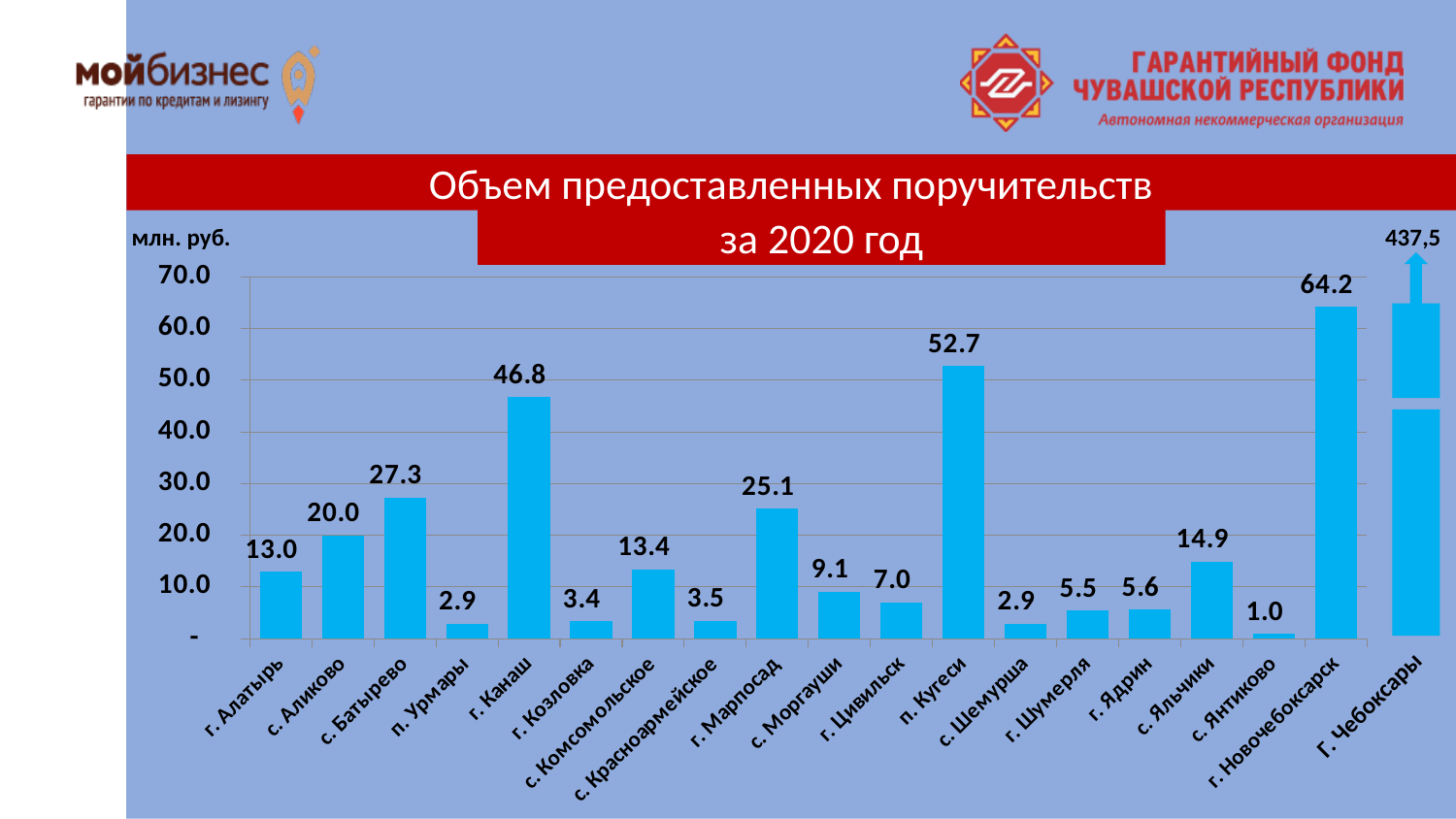
Which is larger, the value for г. Марпосад or the value for с. Аликово? г. Марпосад What is the difference between the values for г. Канаш and с. Батырево? 19.5 What is the difference between the values for г. Новочебоксарск and п. Кугеси? 11.5 What is the value for с. Батырево? 27.3 Which category has the lowest value? с. Янтиково Which category has the highest value? Г. Чебоксары What is the value for Г. Чебоксары? 437,5 What unit is shown above the vertical axis? млн. руб. How many categories are shown on the x axis? 19 What is the value for п. Кугеси? 52.7 What is the value for г. Канаш? 46.8 What kind of chart is this? bar chart